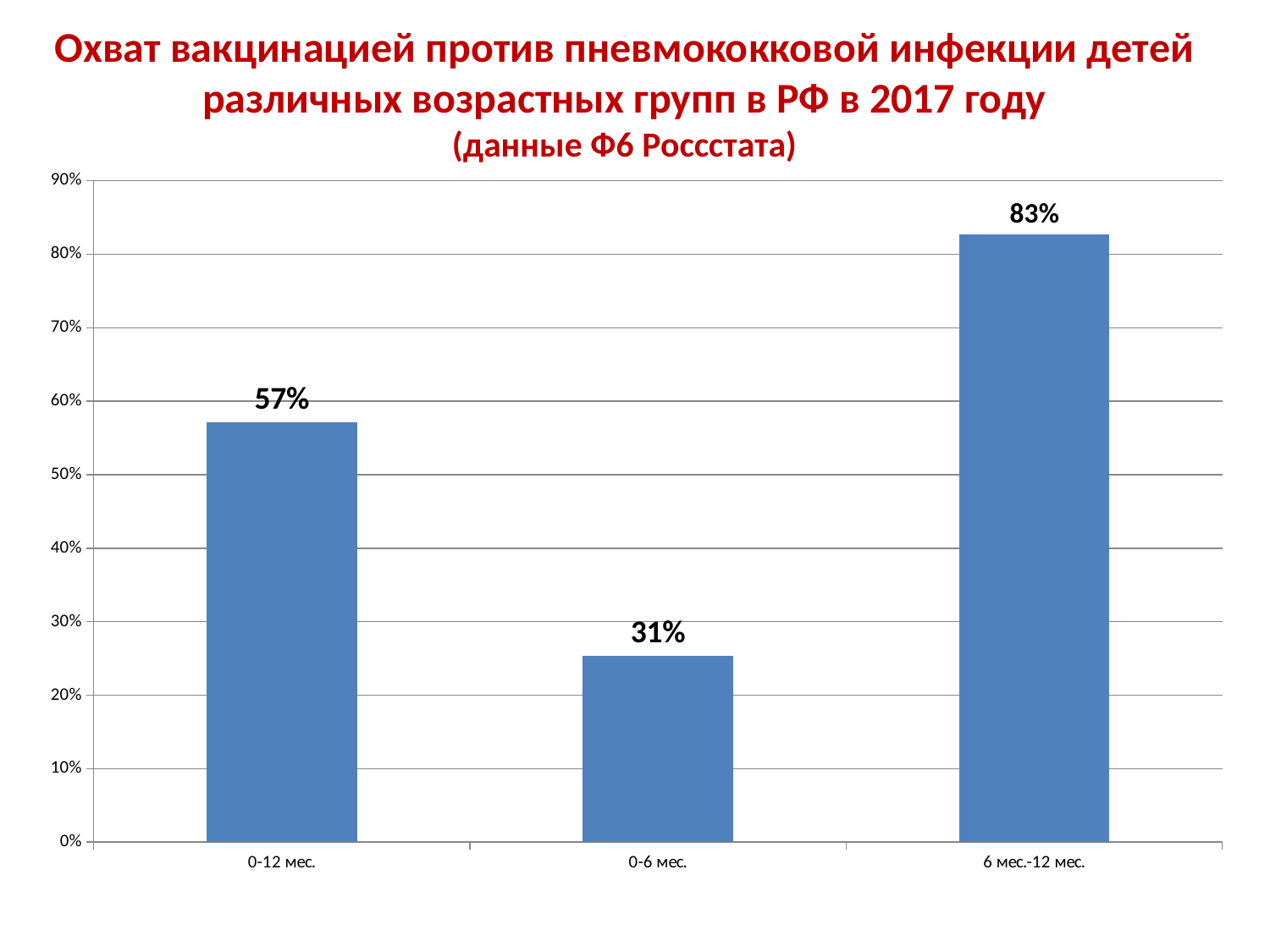
Which age group has the lowest vaccination coverage? 0-6 мес. What is the value shown for the 0-6 мес. group? 31% What is the value shown for the 6 мес.-12 мес. group? 83% What is the maximum value shown on the vertical axis? 90% Is the value for 6 мес.-12 мес. greater or less than 80%? greater How many age groups are shown on the chart? 3 What kind of chart is shown on the slide? Bar chart What is the vaccination coverage value shown for the 0-12 мес. group? 57% Which age group has the highest vaccination coverage? 6 мес.-12 мес. What is the difference between the values for 0-12 мес. and 0-6 мес.? 26% What is the difference between the values for 6 мес.-12 мес. and 0-12 мес.? 26% Which is larger, the value for 0-12 мес. or the value for 0-6 мес.? 0-12 мес.